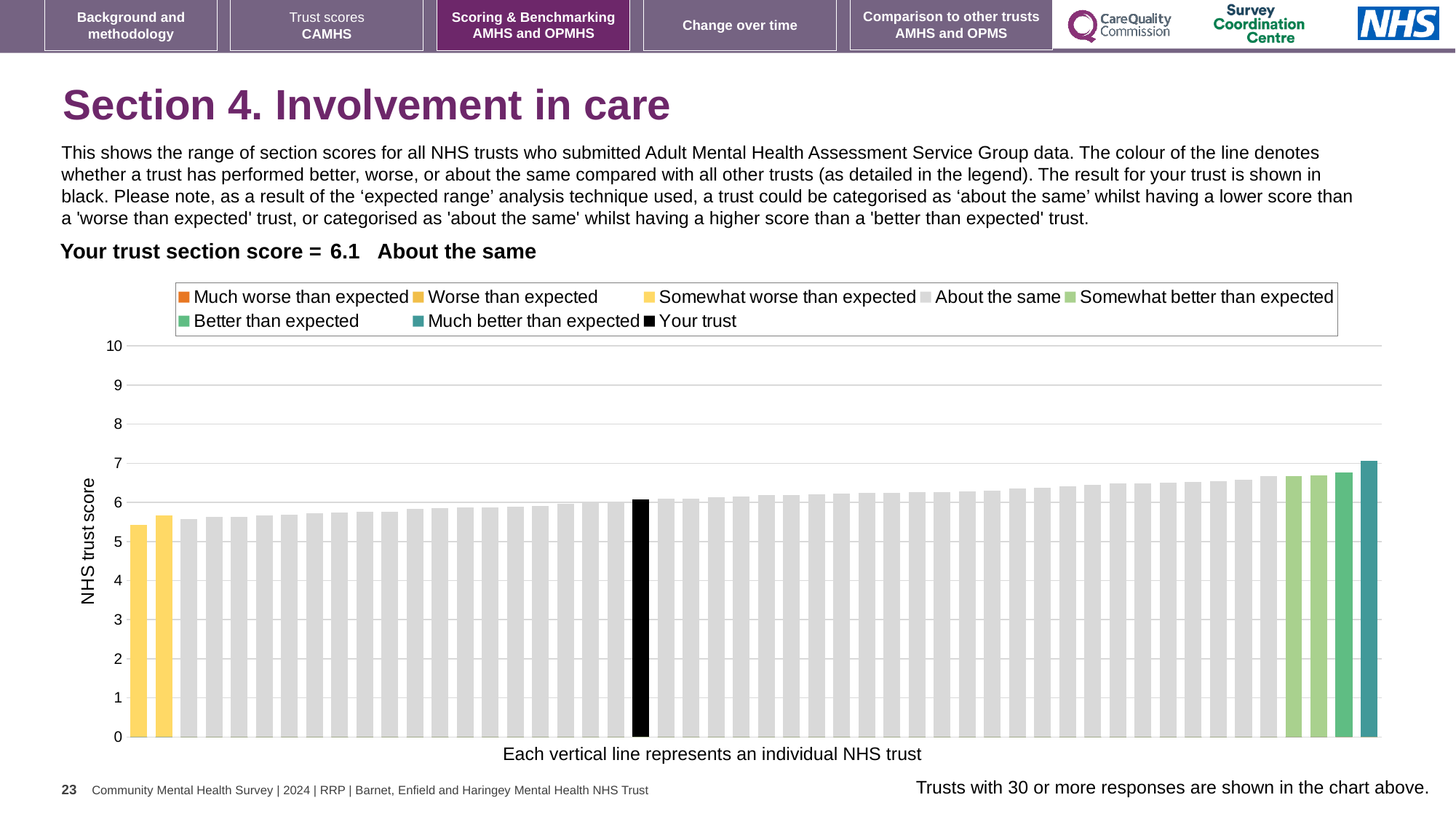
What kind of chart is shown on the slide? bar chart What colour is the bar representing your trust? black Do the bar values rise or fall from left to right across the chart? rise What is the label on the vertical axis of the chart? NHS trust score What is the highest value shown on the vertical axis? 10 Is the value of the shortest bar in the chart greater or less than 5? greater Is the value of the tallest bar in the chart greater or less than 8? less What is the section score for your trust shown on the slide? 6.1 Which category is your trust placed in for this section? About the same How many entries does the chart legend list? 8 Which legend category does the tallest bar in the chart belong to? Much better than expected Is the value for your trust (the black bar) greater or less than 7? less